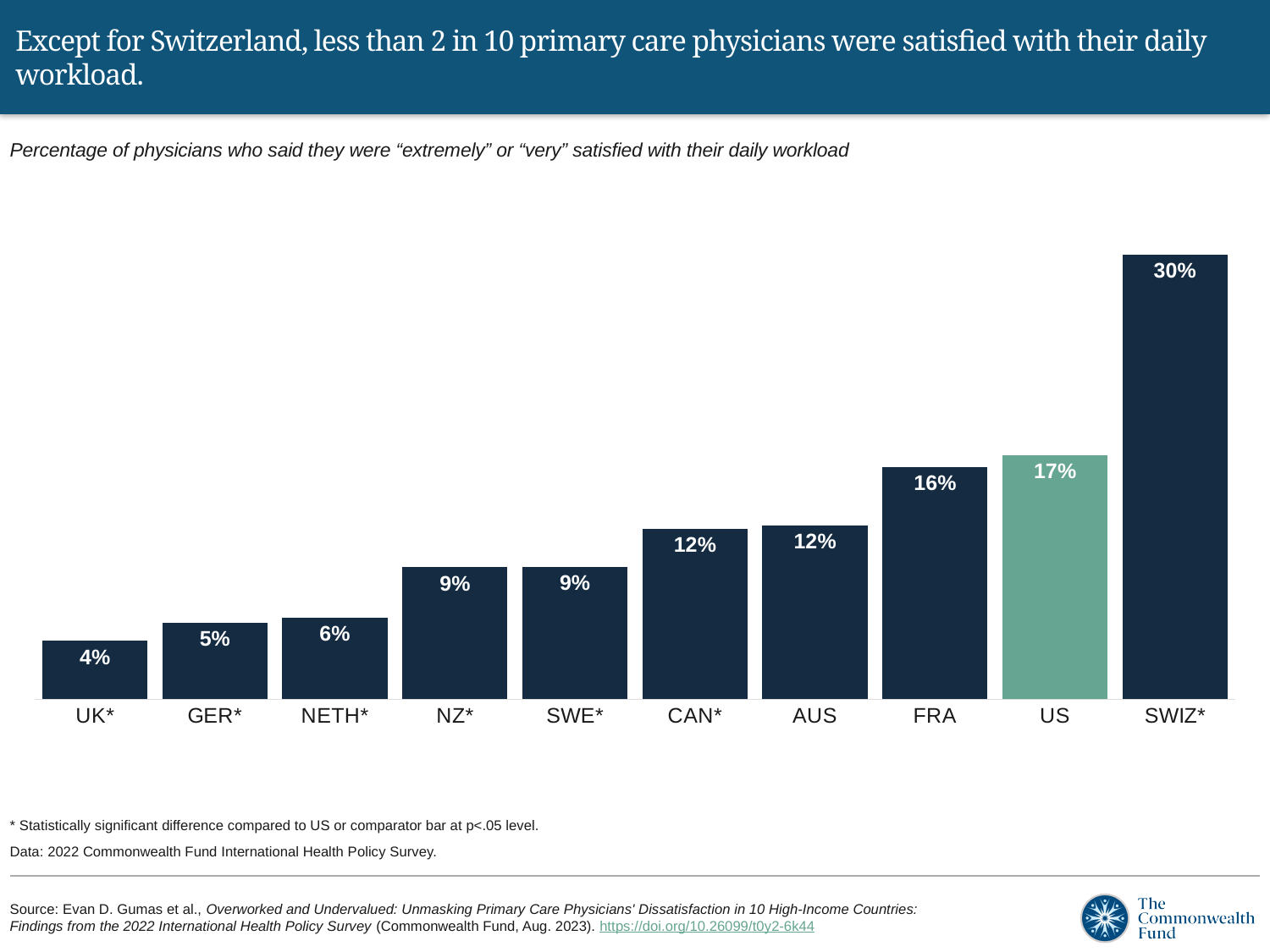
Which country has the highest percentage of physicians satisfied with their daily workload? SWIZ* Do the values rise or fall moving from left to right across the chart? Rise What kind of chart is shown on the slide? Bar chart What is the difference in percentage points between CAN* and GER*? 7 What is the difference in percentage points between SWIZ* and US? 13 Which country's bar is shown in a different colour (green) from the others? US How many countries are shown in the chart? 10 What percentage of physicians in the US said they were extremely or very satisfied with their daily workload? 17% What is the value shown for FRA? 16% What is the value shown for NETH*? 6% Which has a higher value, FRA or NZ*? FRA Which country has the lowest percentage of physicians satisfied with their daily workload? UK*